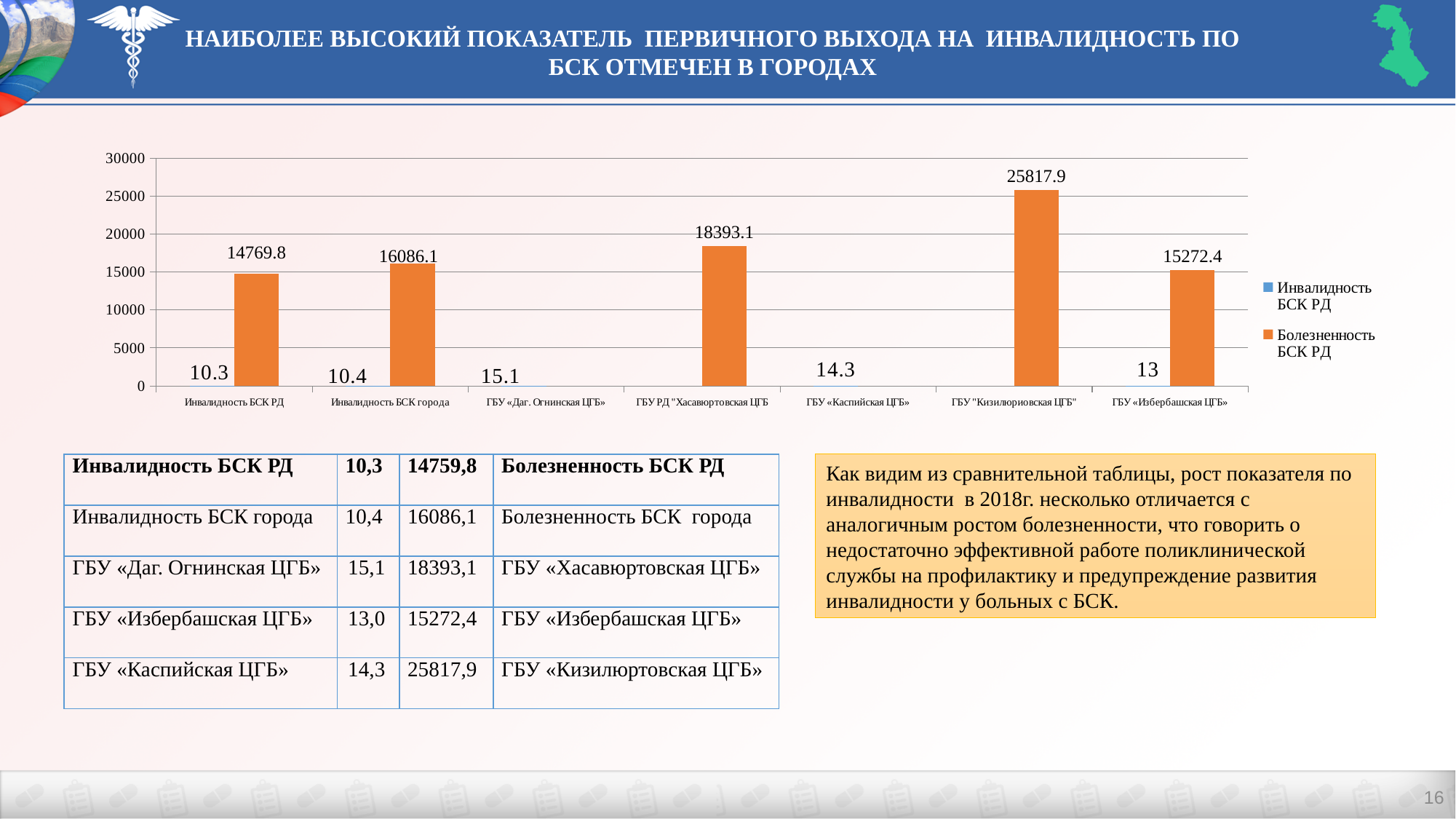
What is the Болезненность БСК РД value for ГБУ "Кизилюриовская ЦГБ"? 25817.9 What is the Инвалидность БСК РД value for ГБУ «Даг. Огнинская ЦГБ»? 15.1 What is the difference between the Болезненность БСК РД values for ГБУ "Кизилюриовская ЦГБ" and ГБУ «Избербашская ЦГБ»? 10545.5 How many series does the chart legend list? 2 Which category has the highest Инвалидность БСК РД value? ГБУ «Даг. Огнинская ЦГБ» Is the Болезненность БСК РД value for ГБУ "Кизилюриовская ЦГБ" greater or less than 20000? greater How many categories are shown along the x axis of the chart? 7 Which category has the highest Болезненность БСК РД value? ГБУ "Кизилюриовская ЦГБ" What is the Инвалидность БСК РД value for ГБУ «Каспийская ЦГБ»? 14.3 Which category has the lowest Болезненность БСК РД bar? Инвалидность БСК РД What kind of chart is shown on the slide? bar chart Which has the larger Болезненность БСК РД value: ГБУ РД "Хасавюртовская ЦГБ or Инвалидность БСК города? ГБУ РД "Хасавюртовская ЦГБ